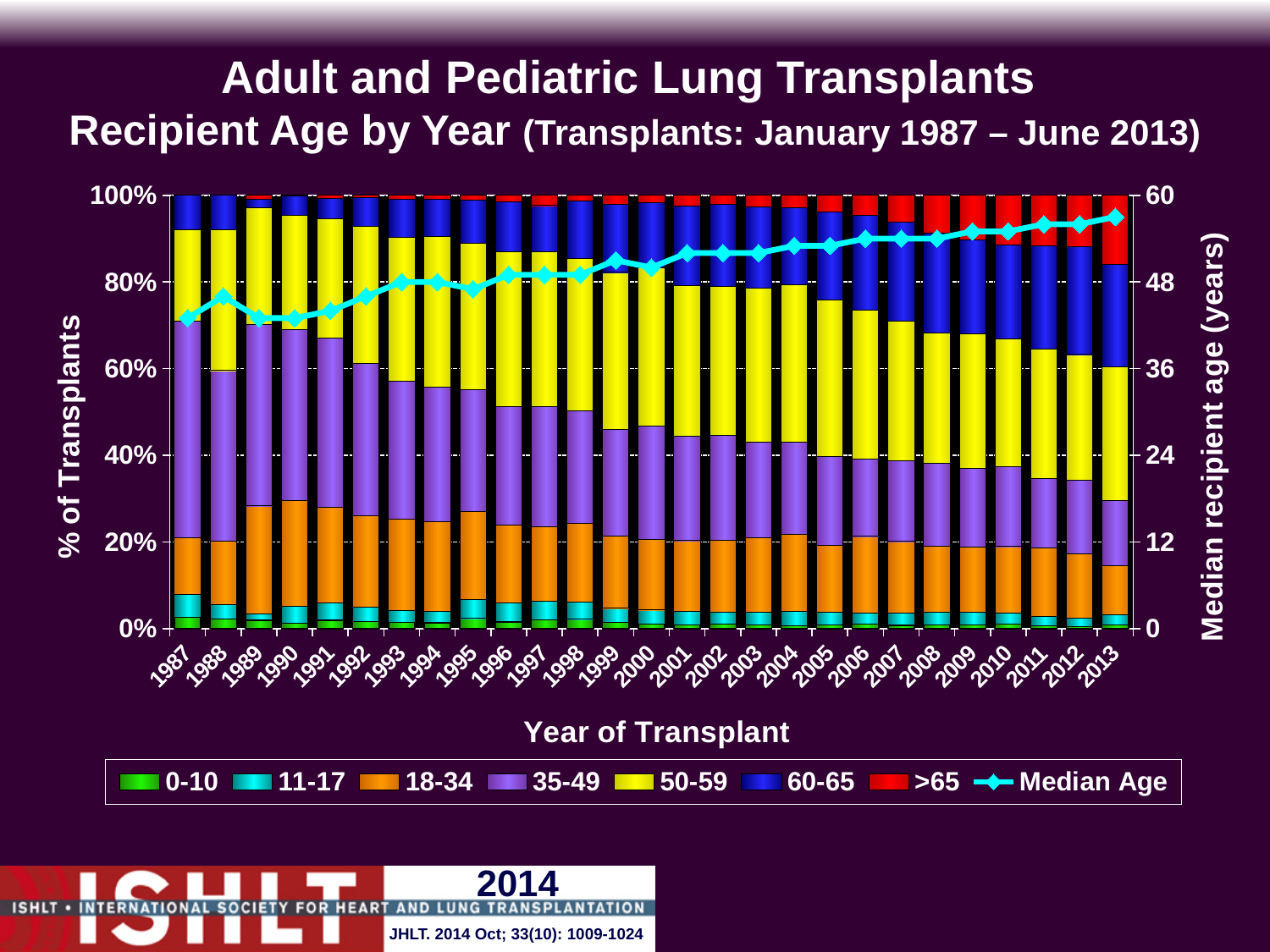
Is the median recipient age for 2013 greater or less than 48 years? greater How many entries does the chart's legend list? 8 Is the median recipient age for 1987 greater or less than 48 years? less What kind of chart is shown on the slide? Stacked bar chart with a line How many years are shown along the x axis of the chart? 27 Which year has the highest median recipient age? 2013 What is the title of the right-hand vertical axis? Median recipient age (years) Is the median recipient age for 2010 greater or less than 48 years? greater Does the median recipient age rise or fall from 1987 to 2013? Rise Which year has the larger median recipient age, 1987 or 2013? 2013 Which colour represents the >65 age group in the legend? Red